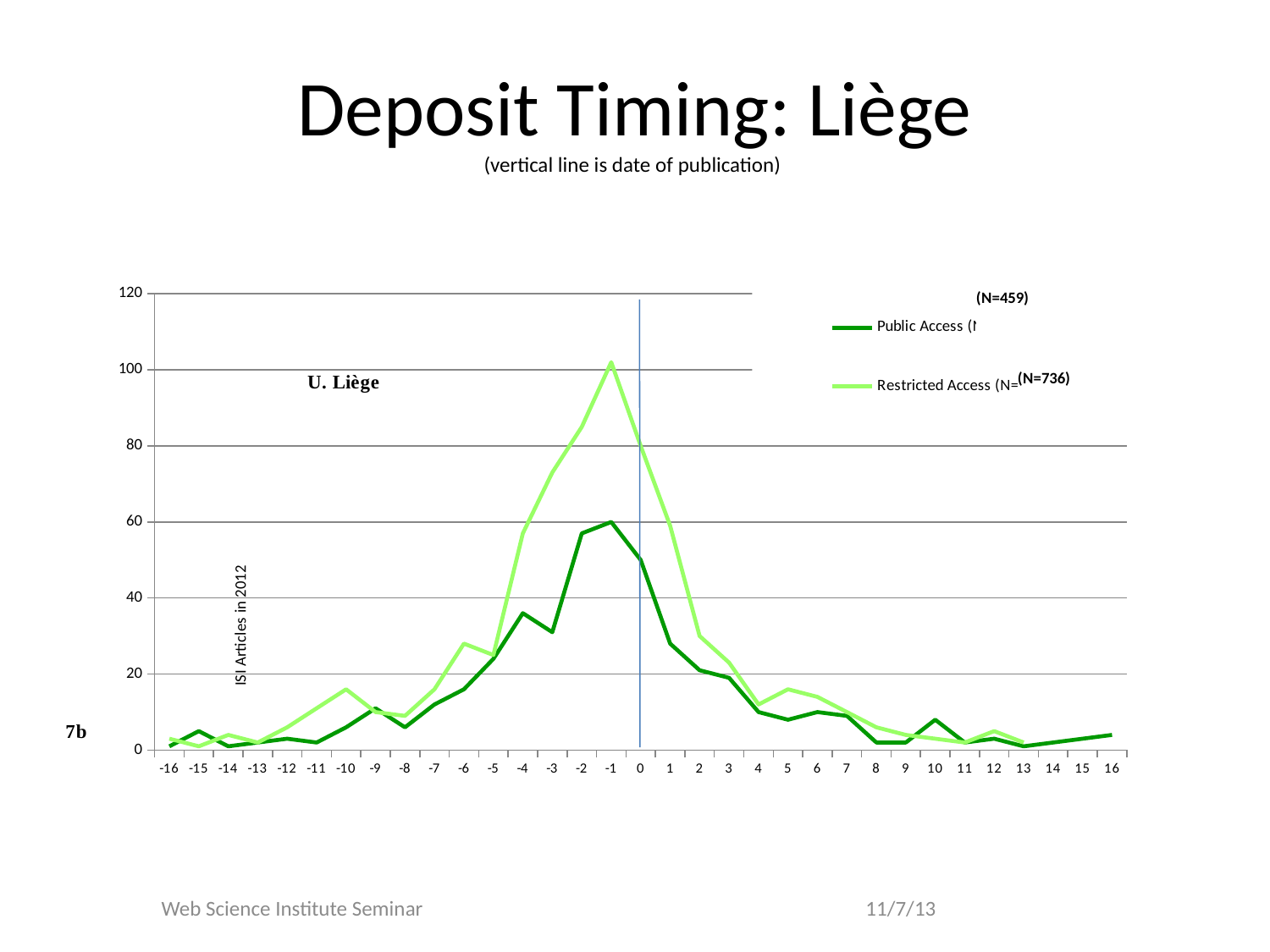
What N value is shown for the Public Access series in the legend? N=459 At which x value does the Public Access line reach its highest point? -1 How many x-axis points are plotted (from -16 to 16)? 33 Is the value for Restricted Access at x = 2 greater or less than 40? less What is the label on the y axis of the chart? ISI Articles in 2012 At x = -1, which series has the higher value, Public Access or Restricted Access? Restricted Access How many series does the legend list? 2 What kind of chart is shown on the slide? line chart Does the Restricted Access line rise or fall from x = -1 to x = 4? fall Is the value for Public Access at x = -1 greater or less than 80? less At which x value does the Restricted Access line reach its highest point? -1 Is the value for Restricted Access at x = -1 greater or less than 80? greater